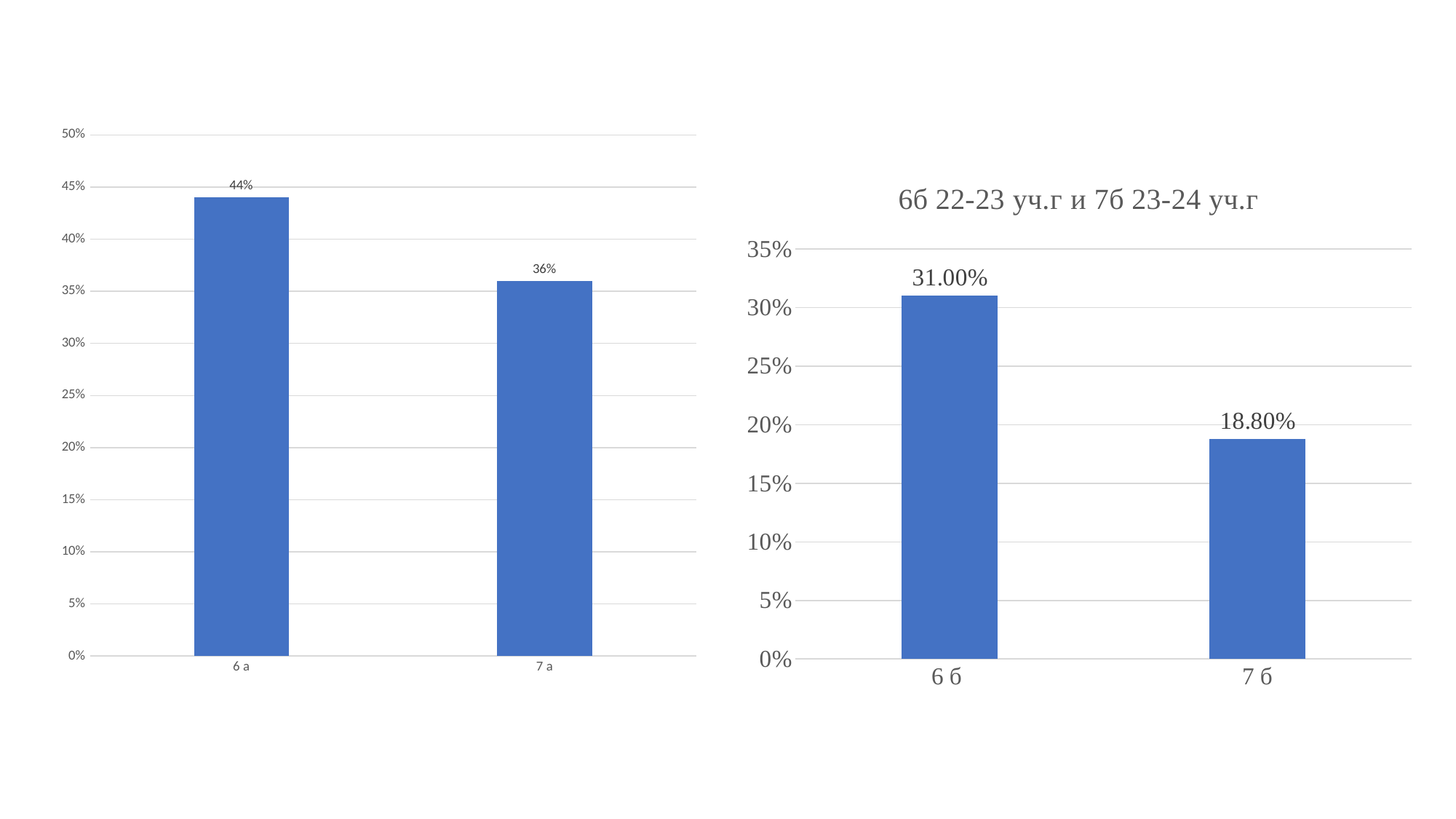
In the left chart, what is the value for 7 а? 36% In the left chart, how many bars are plotted? 2 What kind of chart is the right chart? bar chart In the chart titled '6б 22-23 уч.г и 7б 23-24 уч.г', what is the value for 6 б? 31.00% In the left chart, what is the difference between the values for 6 а and 7 а? 8% In the left chart, what is the value for 6 а? 44% What is the title of the right chart? 6б 22-23 уч.г и 7б 23-24 уч.г In the chart titled '6б 22-23 уч.г и 7б 23-24 уч.г', which category has the lowest value? 7 б In the chart titled '6б 22-23 уч.г и 7б 23-24 уч.г', what is the difference between the values for 6 б and 7 б? 12.20% In the chart titled '6б 22-23 уч.г и 7б 23-24 уч.г', is the value for 7 б greater or less than 20%? less In the left chart, which category has the highest value? 6 а In the chart titled '6б 22-23 уч.г и 7б 23-24 уч.г', what is the value for 7 б? 18.80%